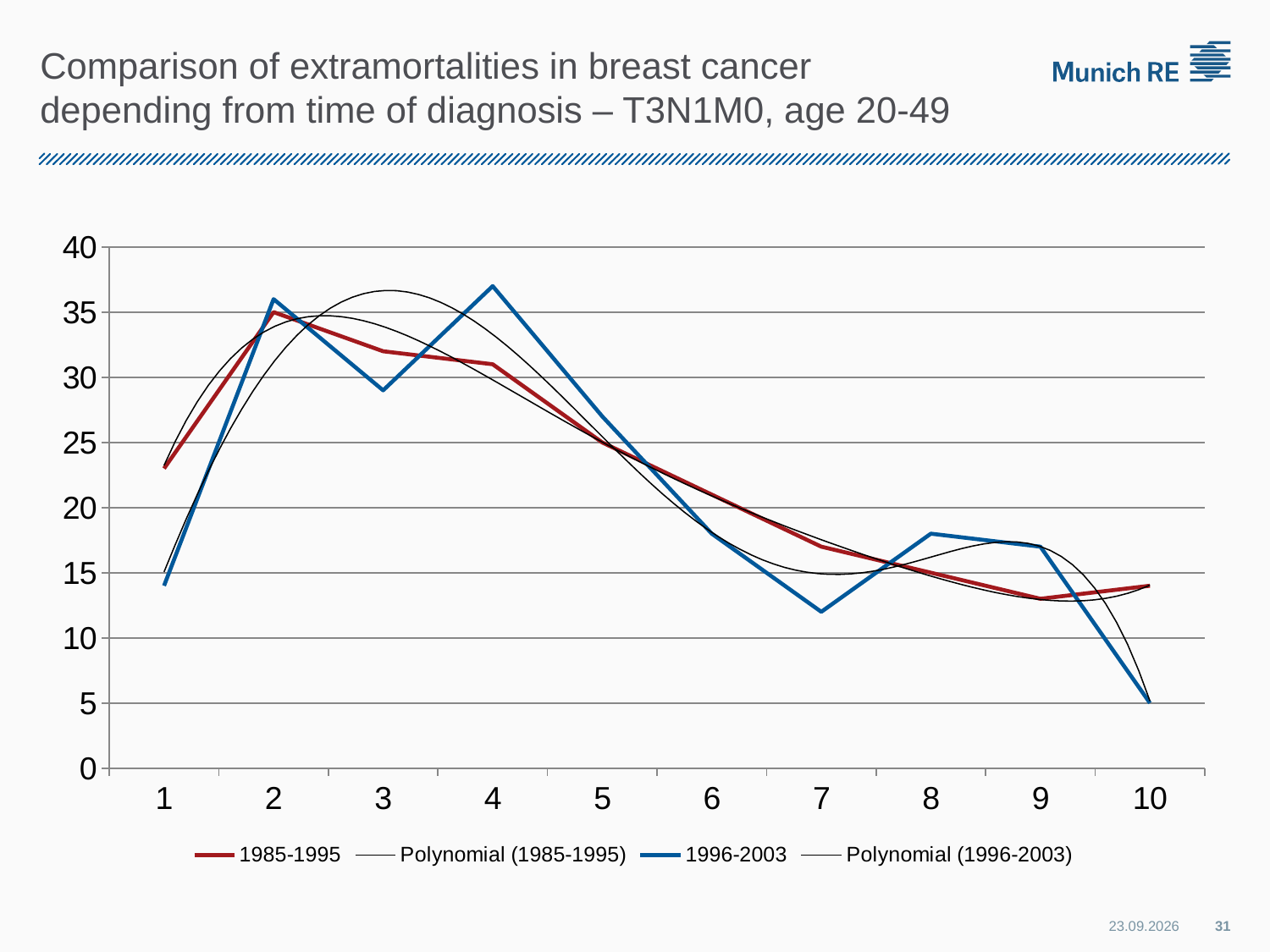
At which point does the 1996-2003 series reach its lowest value? 10 What is the value of the 1985-1995 series at point 2? 35 How many points are plotted along the x axis for each series? 10 What kind of chart is shown on the slide? line chart What is the value of the 1996-2003 series at point 10? 5 Is the value of the 1996-2003 series at point 7 greater or less than 15? less Is the value of the 1985-1995 series at point 1 greater or less than 25? less Is the value of the 1996-2003 series at point 4 greater or less than 35? greater At point 7, which series has the larger value, 1985-1995 or 1996-2003? 1985-1995 At which point does the 1985-1995 series reach its highest value? 2 How many entries does the legend list? 4 Does the 1996-2003 series rise or fall from point 4 to point 7? fall